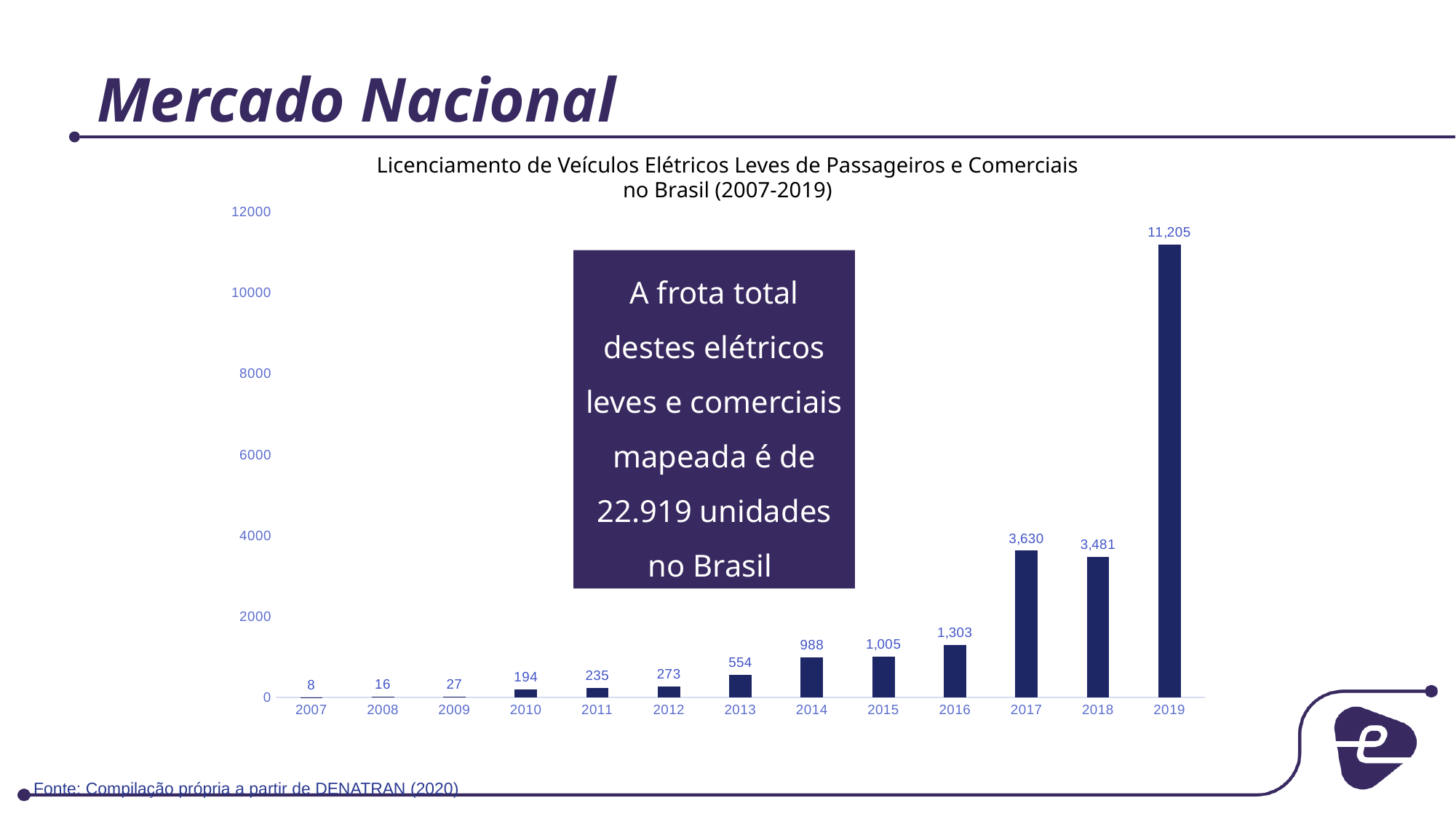
What is the value for 2013? 554 What is the difference between the values for 2017 and 2018? 149 What kind of chart is this? bar chart Which year has the lowest value? 2007 Which year has the highest value? 2019 How many years are shown on the x axis? 13 What is the title of the chart? Licenciamento de Veículos Elétricos Leves de Passageiros e Comerciais no Brasil (2007-2019) What is the value for 2019? 11,205 Which is larger, the value for 2014 or the value for 2015? 2015 Do the values generally rise or fall from 2007 to 2019? rise Is the value for 2016 greater or less than 2000? less What is the value for 2007? 8